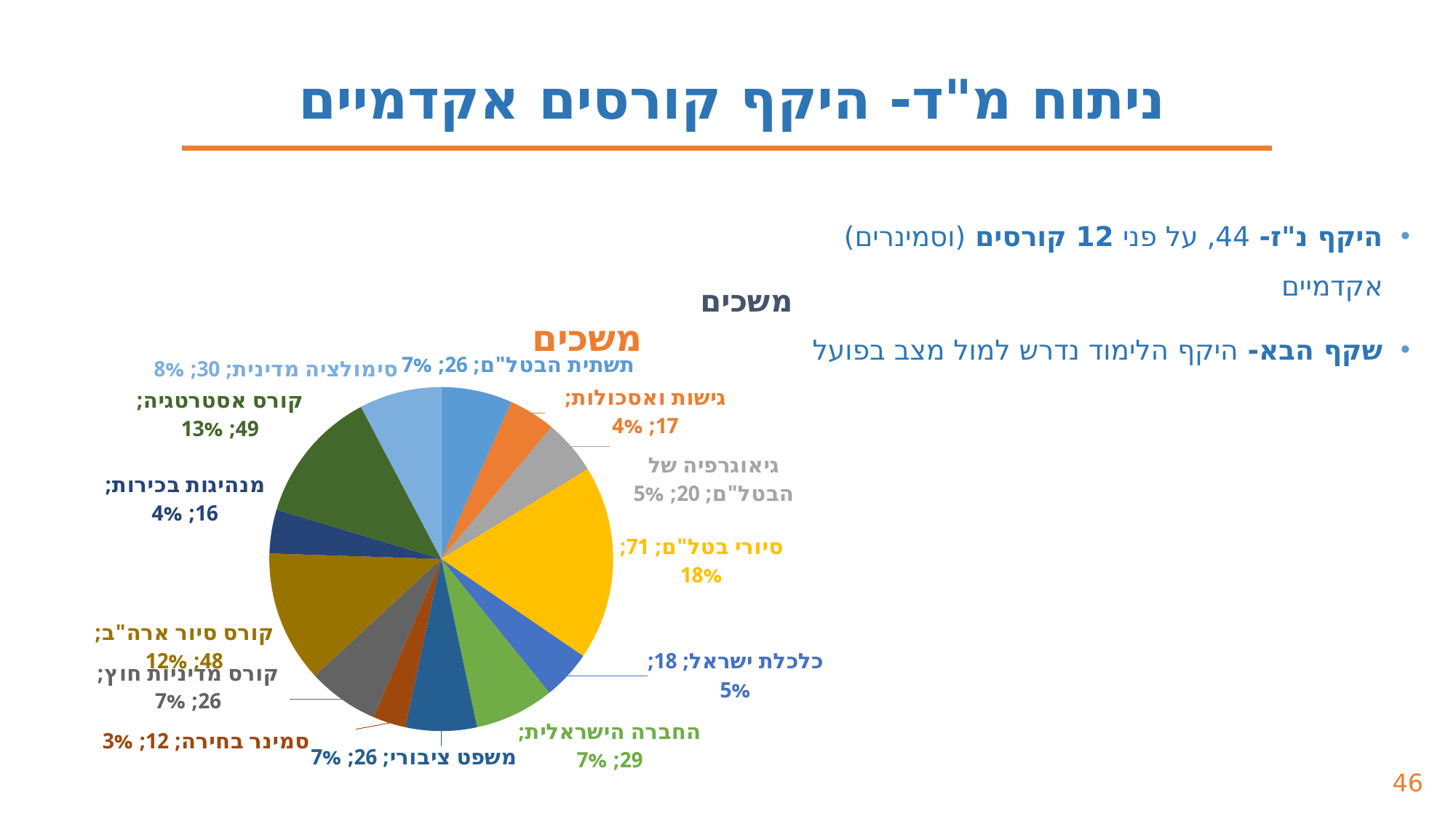
Which category has the largest slice in the pie chart? סיורי בטל"ם What kind of chart is shown on the slide? pie chart What is the difference between the values for סיורי בטל"ם and סמינר בחירה? 59 What is the difference between the values for קורס אסטרטגיה and קורס סיור ארה"ב? 1 What value is shown for סימולציה מדינית in the pie chart? 30 What value is shown for סיורי בטל"ם in the pie chart? 71 What percentage share does מנהיגות בכירות have in the pie chart? 4% What percentage share does קורס אסטרטגיה have in the pie chart? 13% Which category has the smallest slice in the pie chart? סמינר בחירה Which is larger, the value for החברה הישראלית or the value for כלכלת ישראל? החברה הישראלית What is the title of the pie chart? משכים How many slices does the pie chart have? 13